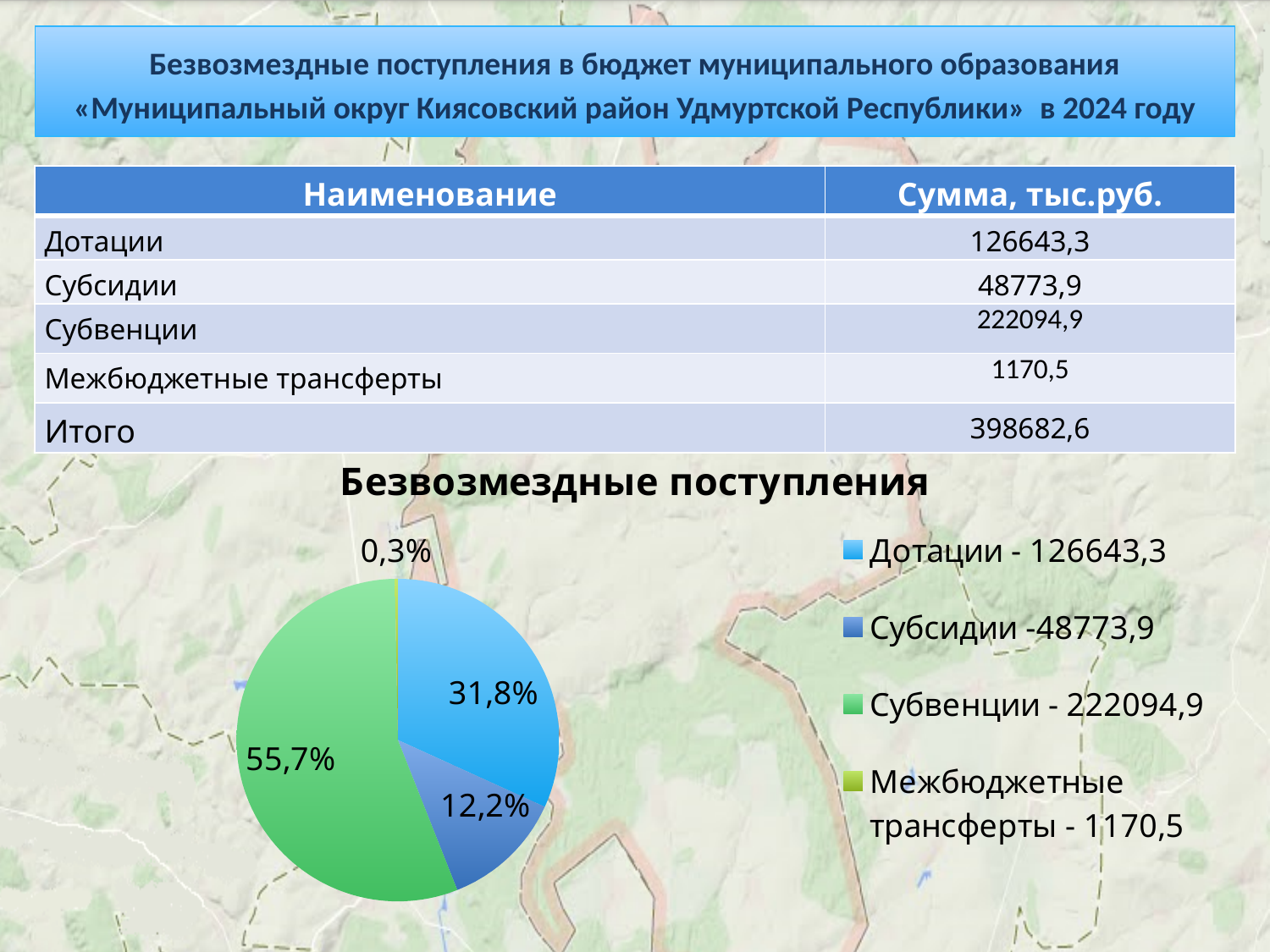
What share of the pie does Дотации take? 31,8% What is the difference in percentage points between the Субвенции slice and the Дотации slice? 23,9% What kind of chart is shown on the slide? pie chart What share of the pie does Субсидии take? 12,2% How many entries does the chart legend list? 4 What share of the pie does Субвенции take? 55,7% How many slices does the pie chart have? 4 What is the title of the chart? Безвозмездные поступления Which slice is larger, Дотации or Субсидии? Дотации Which category has the smallest slice of the pie? Межбюджетные трансферты Which category has the largest slice of the pie? Субвенции